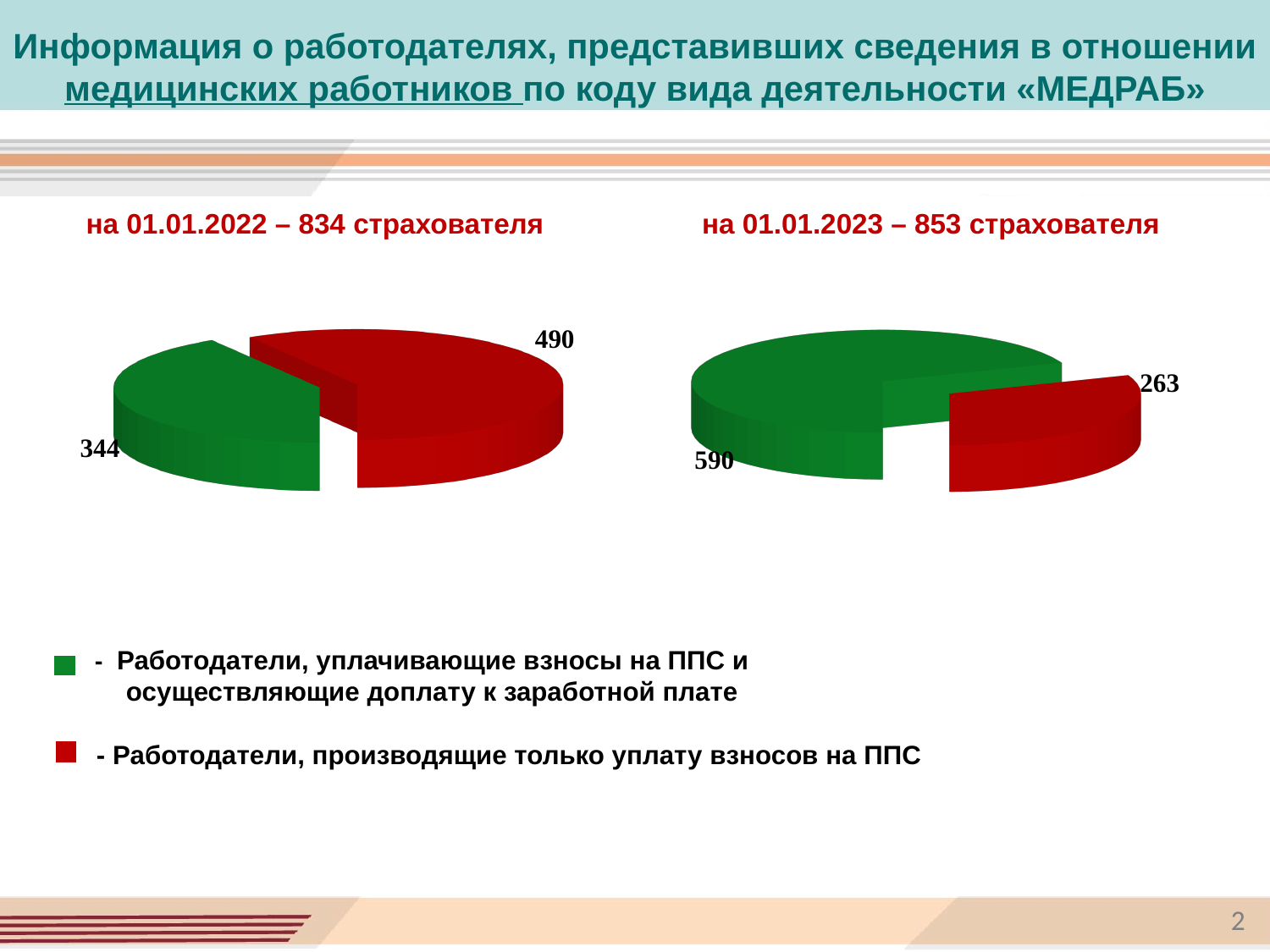
In the right pie chart (на 01.01.2023), what is the value of the green slice? 590 What kind of chart is shown on the left of the slide (на 01.01.2022)? pie chart How many slices does each pie chart on the slide have? 2 In the left pie chart (на 01.01.2022), what is the value of the green slice (employers paying ППС contributions and salary supplements)? 344 In the left pie chart (на 01.01.2022), what is the value of the red slice (employers paying only ППС contributions)? 490 What is the total number of страхователей shown for the right pie chart (на 01.01.2023)? 853 In the right pie chart (на 01.01.2023), what is the difference between the green slice and the red slice? 327 Which colour in the legend represents employers that only pay ППС contributions? red In the left pie chart (на 01.01.2022), which slice is larger, the green or the red? red In the left pie chart (на 01.01.2022), what is the difference between the red slice and the green slice? 146 In the right pie chart (на 01.01.2023), which category is the largest? Работодатели, уплачивающие взносы на ППС и осуществляющие доплату к заработной плате (green) In the right pie chart (на 01.01.2023), what is the value of the red slice? 263